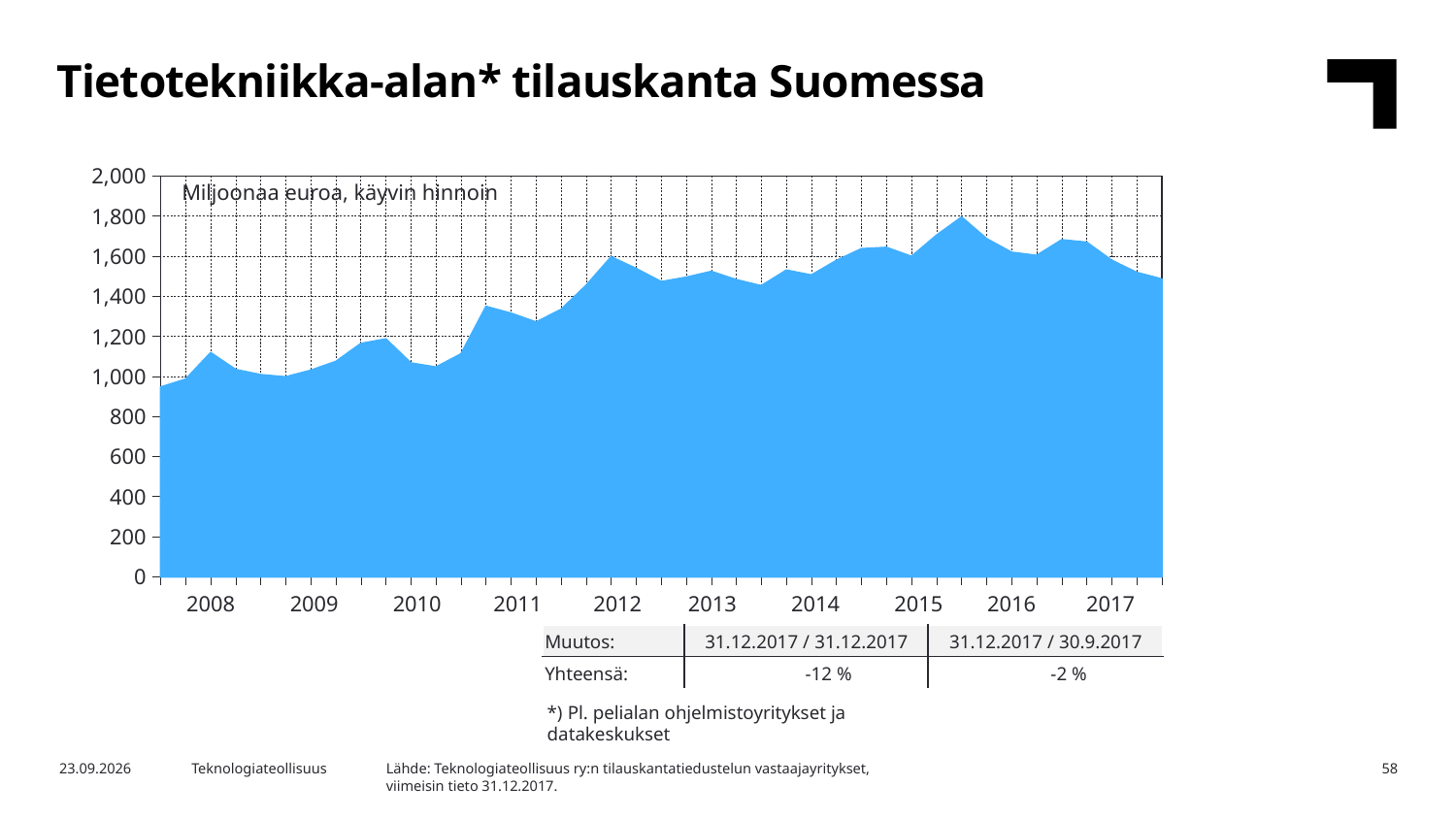
Is the value at the start of 2010 greater or less than 1,000? greater Overall, does the order backlog rise or fall from 2008 to 2017? rise What unit is stated inside the chart area? Miljoonaa euroa, käyvin hinnoin Is the value at the start of 2013 greater or less than 1,400? greater Is the peak value of the series greater or less than 1,600? greater How many years are labelled on the x axis? 10 What is the title of the chart on the slide? Tietotekniikka-alan* tilauskanta Suomessa What is the highest value shown on the y axis? 2,000 Is the value at the start of 2008 larger or smaller than the value at the end of 2017? smaller According to the table below the chart, what is the change (Muutos) for 31.12.2017 / 30.9.2017? -2 % What kind of chart is shown on the slide? area chart